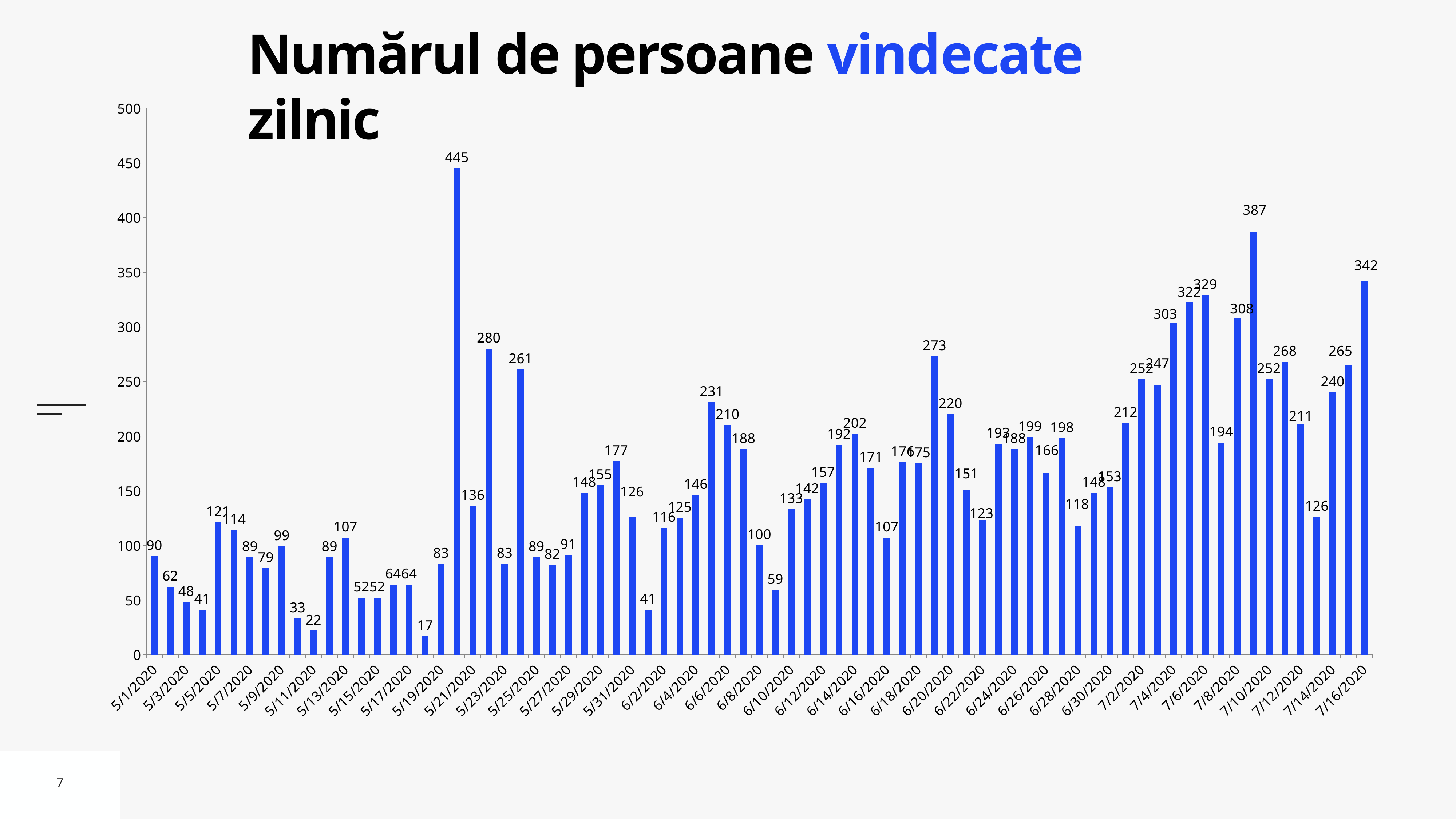
What is the difference between the value for 7/16/2020 and the value for 5/1/2020? 252 What is the title of the chart? Numărul de persoane vindecate zilnic What is the highest daily value shown in the chart? 445 Which is larger, the value for 7/16/2020 or the value for 5/1/2020? 7/16/2020 What is the difference between the highest bar (445) and the second highest bar (387)? 58 What colour are the bars in the chart? blue Overall, do the daily values rise or fall from May to July along the x axis? rise What kind of chart is shown on the slide? bar chart What is the value for 5/1/2020, the first bar in the chart? 90 What is the value for 7/16/2020, the last bar in the chart? 342 What is the lowest daily value shown in the chart? 17 Is the value for 7/16/2020 greater or less than 300? greater